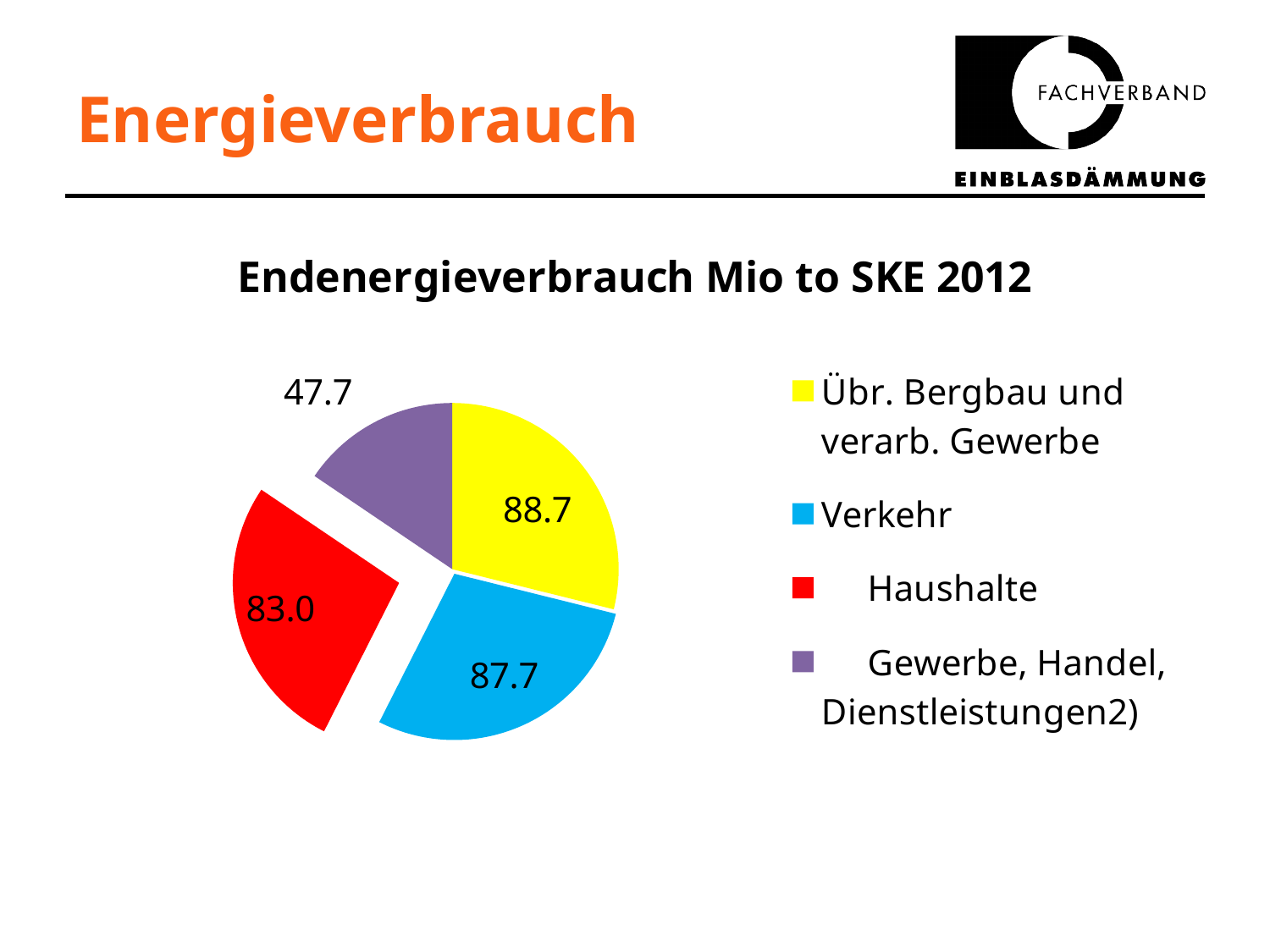
Which category has the largest value? Übr. Bergbau und verarb. Gewerbe Which category has the smallest value? Gewerbe, Handel, Dienstleistungen2) What type of chart is shown on the slide? Pie chart What is the title of the chart? Endenergieverbrauch Mio to SKE 2012 What is the difference between the values for Übr. Bergbau und verarb. Gewerbe and Gewerbe, Handel, Dienstleistungen2)? 41.0 How many slices does the pie chart have? 4 What is the value for Übr. Bergbau und verarb. Gewerbe? 88.7 What is the value for Haushalte? 83.0 What is the value for Verkehr? 87.7 Which is larger, the value for Verkehr or the value for Haushalte? Verkehr What is the value for Gewerbe, Handel, Dienstleistungen2)? 47.7 What colour is the Haushalte slice? Red